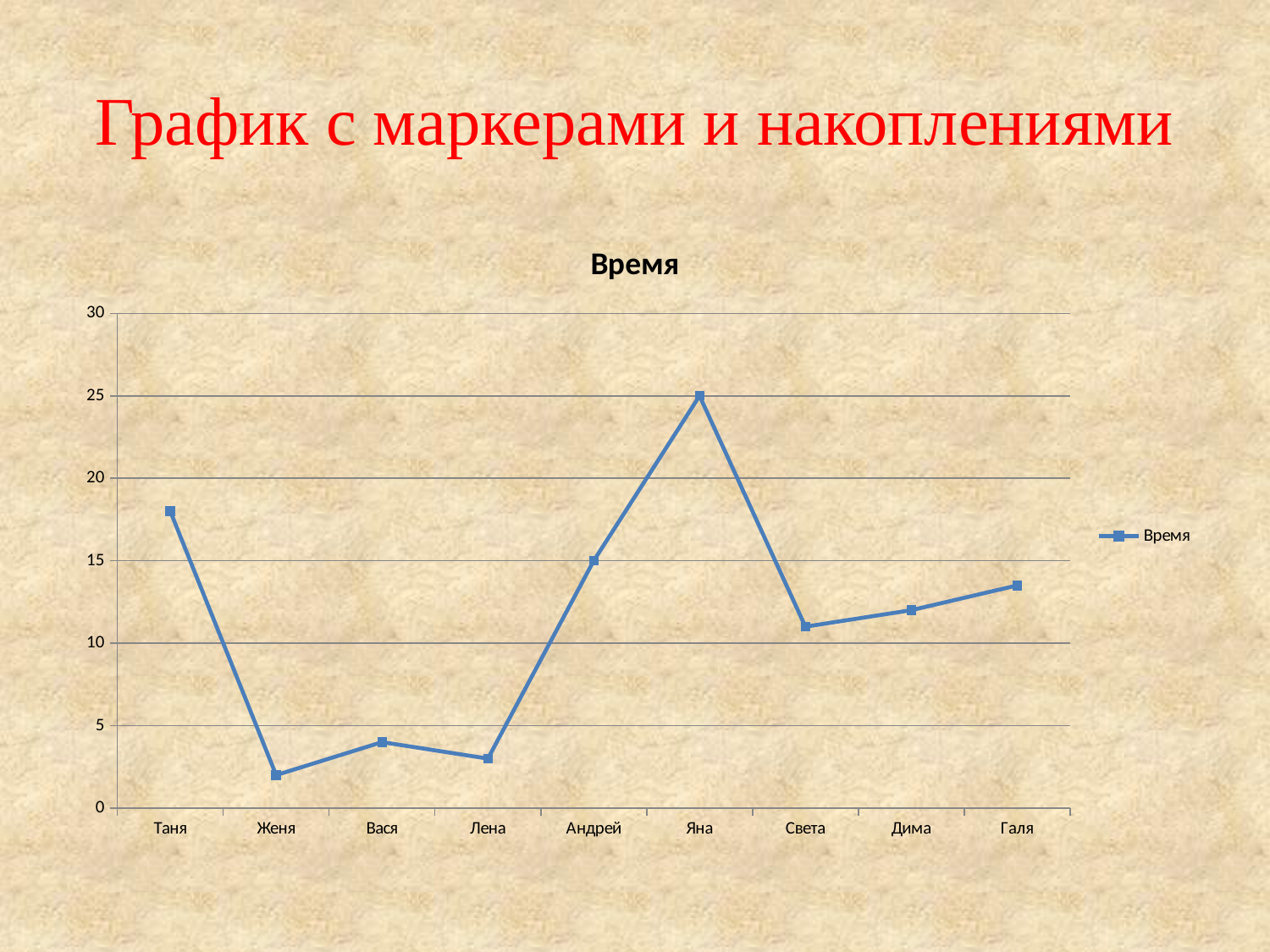
Is the value for Таня greater or less than 15? greater How many categories are shown on the x axis? 9 Do the values rise or fall from Света to Галя? rise Which category has the highest value? Яна Which is larger, the value for Таня or the value for Андрей? Таня What is the value for Андрей? 15 How many series does the legend list? 1 What is the value for Яна? 25 What is the title of the chart? Время Is the value for Галя greater or less than 15? less Is the value for Женя greater or less than 5? less What kind of chart is shown on the slide? line chart